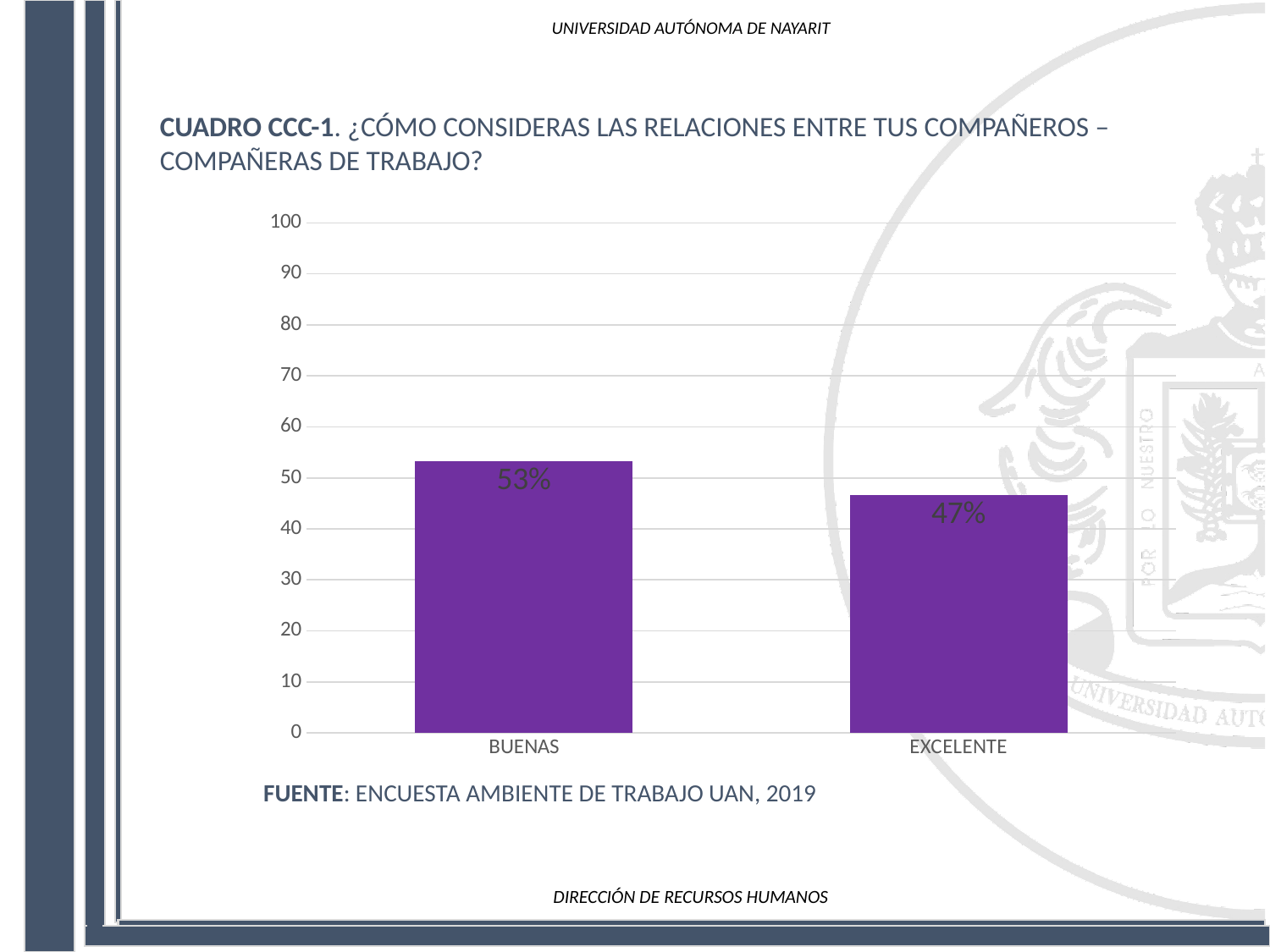
Which category has the highest value? BUENAS Which category has the lowest value? EXCELENTE What source is cited below the chart? ENCUESTA AMBIENTE DE TRABAJO UAN, 2019 What is the total of the two values shown in the chart? 100% What is the value for EXCELENTE? 47% Is the value for EXCELENTE greater or less than 50? less What is the value for BUENAS? 53% Is the value for BUENAS greater or less than 50? greater Which is larger, the value for BUENAS or the value for EXCELENTE? BUENAS What kind of chart is shown on the slide? bar chart How many categories are shown on the x axis? 2 What is the difference between the values for BUENAS and EXCELENTE? 6%